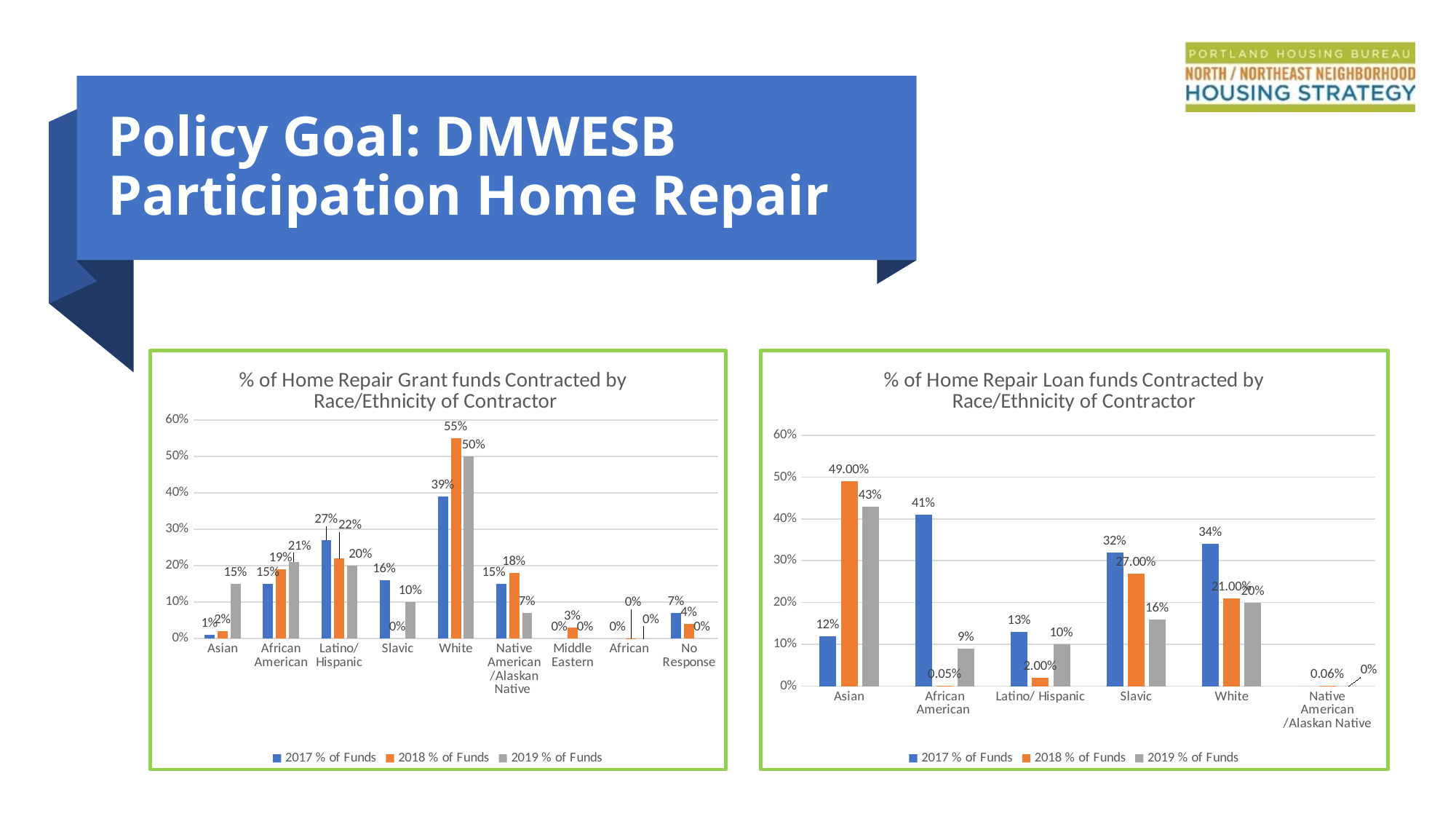
How many categories are shown on the x axis of the Home Repair Grant funds chart? 9 In the Home Repair Loan funds chart, what is the 2017 % of Funds value for African American? 41% In the Home Repair Grant funds chart, which category has the highest 2017 % of Funds value? White What type of chart is the Home Repair Grant funds chart? bar chart In the Home Repair Loan funds chart, what is the difference between the 2017 and 2019 % of Funds values for Slavic? 16% In the Home Repair Grant funds chart, what is the 2018 % of Funds value for White? 55% In the Home Repair Loan funds chart, is the 2017 % of Funds value for Slavic larger or smaller than the 2017 value for White? smaller How many series does the legend of the Home Repair Loan funds chart list? 3 In the Home Repair Loan funds chart, what is the 2018 % of Funds value for Asian? 49.00% In the Home Repair Grant funds chart, what is the 2019 % of Funds value for Asian? 15% In the Home Repair Loan funds chart, which category has the highest 2019 % of Funds value? Asian In the Home Repair Grant funds chart, what is the difference between the 2017 and 2018 % of Funds values for Latino/Hispanic? 5%